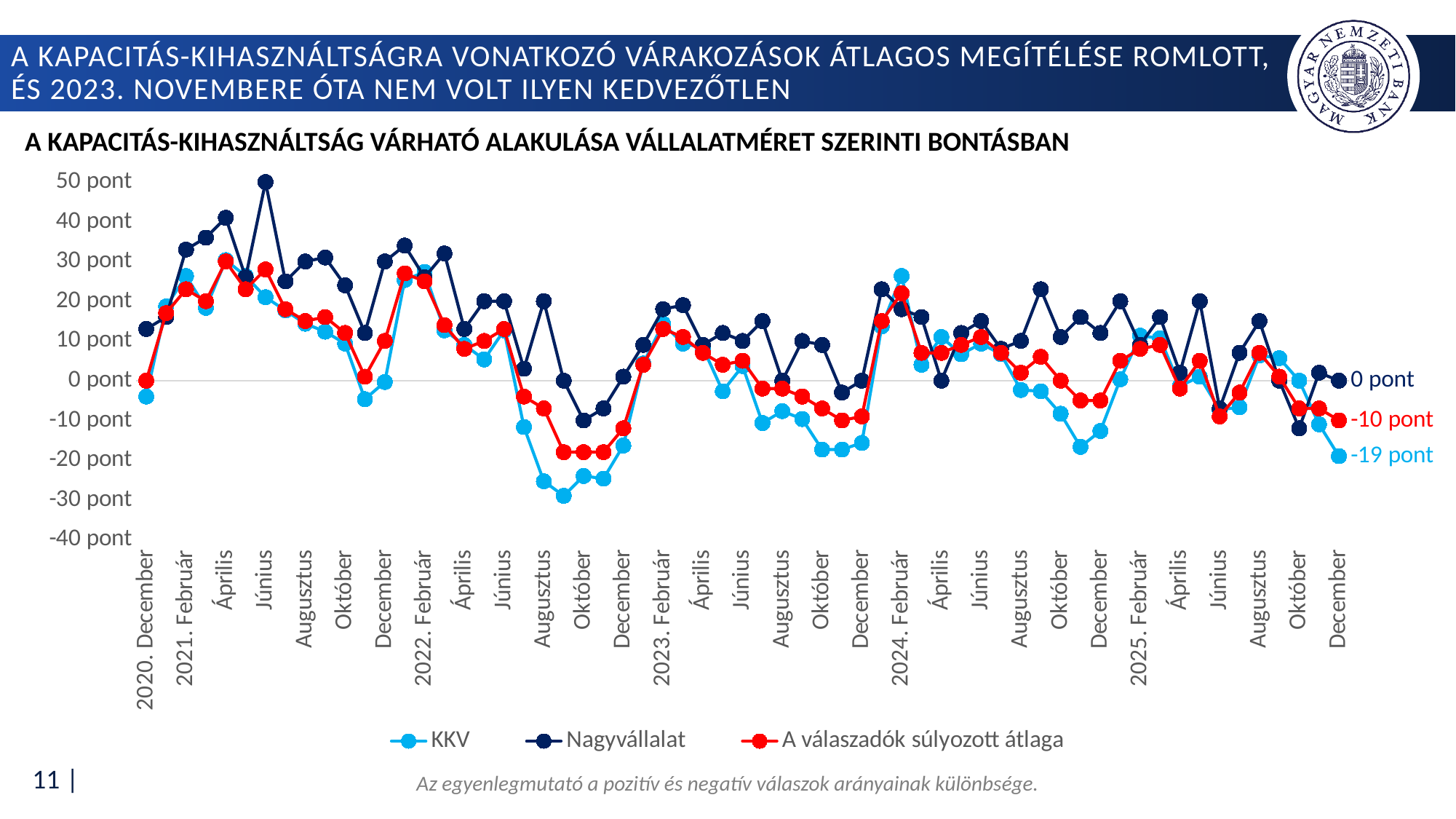
At the final point (2025 December), what is the difference between the Nagyvállalat value and the KKV value? 19 pont At the final point (2025 December), what is the difference between 'A válaszadók súlyozott átlaga' and the KKV value? 9 pont How many series does the legend list? 3 What kind of chart is shown on the slide? Line chart Which series reaches the highest value anywhere on the chart? Nagyvállalat At the final point (2025 December), which series has the higher value: KKV or Nagyvállalat? Nagyvállalat Which series reaches the lowest value anywhere on the chart? KKV What is the value of 'A válaszadók súlyozott átlaga' at the final point (2025 December)? -10 pont Is the Nagyvállalat value in 2021 June greater or less than 40 pont? greater What is the value of the Nagyvállalat series at the final point (2025 December)? 0 pont Is the KKV value in 2022 October greater or less than -20 pont? less What is the value of the KKV series at the final point (2025 December)? -19 pont